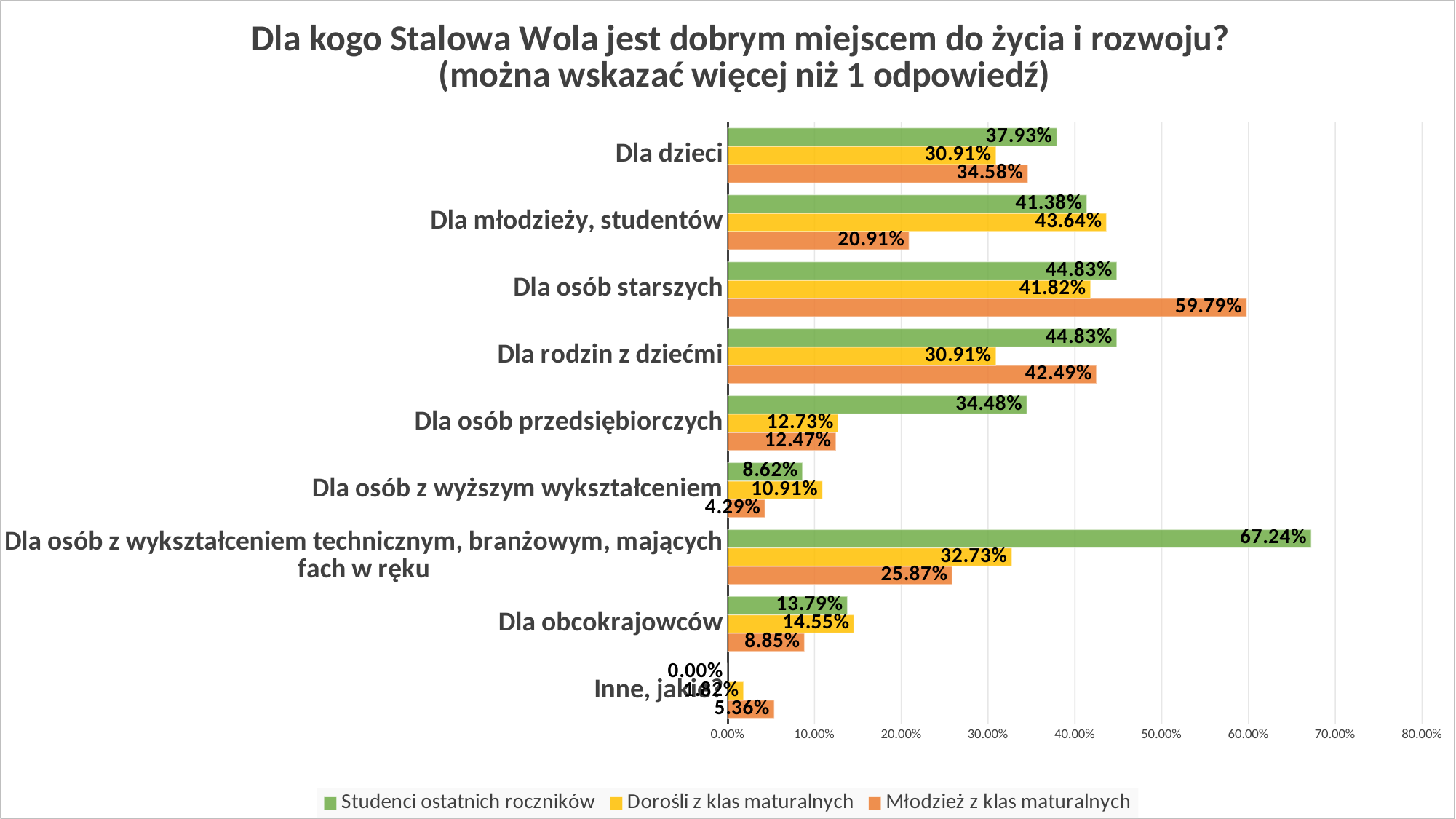
How many series does the legend list? 3 How many categories are shown on the chart? 9 What is the value for 'Studenci ostatnich roczników' in the category 'Dla osób z wykształceniem technicznym, branżowym, mających fach w ręku'? 67.24% For 'Dla rodzin z dziećmi', which is larger: the value for 'Dorośli z klas maturalnych' or for 'Młodzież z klas maturalnych'? Młodzież z klas maturalnych Which colour represents 'Dorośli z klas maturalnych' in the chart? yellow What is the difference between the 'Studenci ostatnich roczników' and 'Młodzież z klas maturalnych' values for 'Dla osób przedsiębiorczych'? 22.01% What type of chart is shown on the slide? bar chart Which category has the lowest value for 'Studenci ostatnich roczników'? Inne, jakie? Is the value for 'Studenci ostatnich roczników' in 'Dla dzieci' greater or less than 30.00%? greater What is the value for 'Dorośli z klas maturalnych' in the category 'Dla młodzieży, studentów'? 43.64% Which category has the highest value for 'Młodzież z klas maturalnych'? Dla osób starszych What is the value for 'Młodzież z klas maturalnych' in the category 'Dla osób starszych'? 59.79%